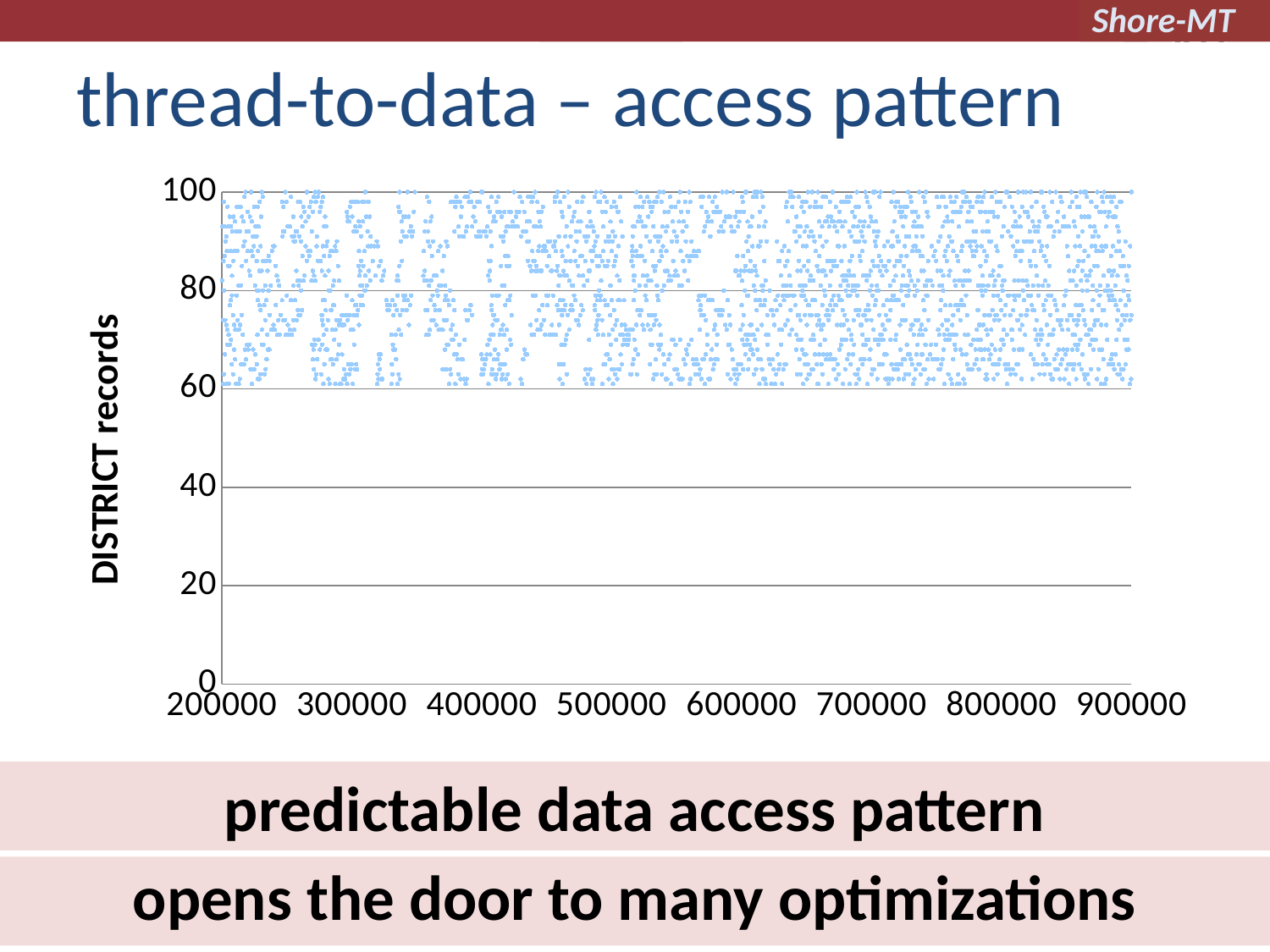
What is the interval between consecutive tick labels on the y axis of the chart? 20 Are the plotted points in the chart greater or less than 60 on the y axis? greater How many tick labels are shown on the x axis of the chart? 8 What is the label of the y axis of the chart? DISTRICT records What is the lowest value shown on the x axis of the chart? 200000 What is the highest value shown on the y axis of the chart? 100 What is the highest value shown on the x axis of the chart? 900000 Do the plotted points in the chart show a rising or falling trend along the x axis, or no clear trend? no clear trend Are the plotted points in the chart greater or less than 40 on the y axis? greater What kind of chart is shown on the slide? scatter chart How many tick labels are shown on the y axis of the chart? 6